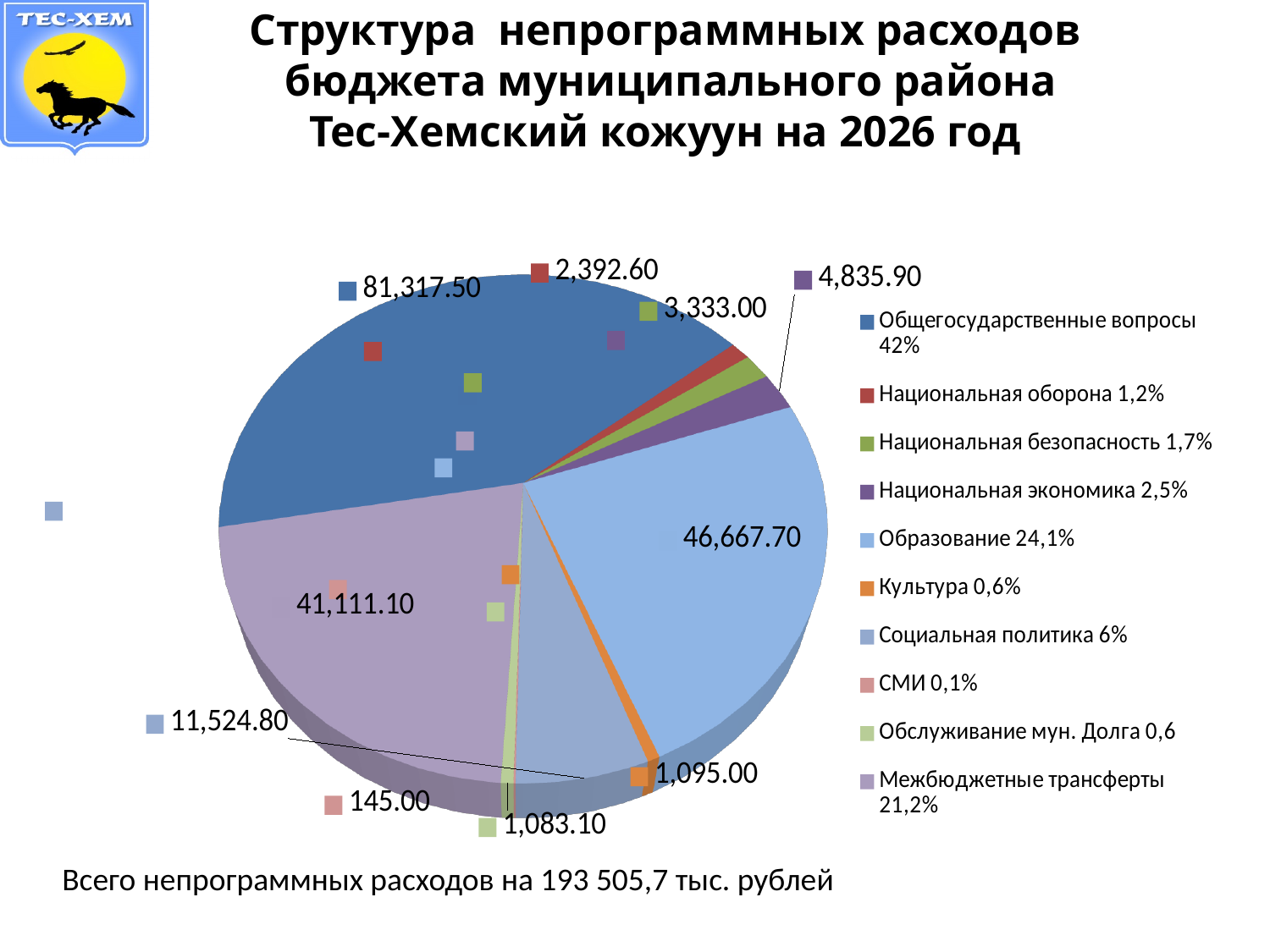
What is the value shown for Общегосударственные вопросы? 81,317.50 What is the value shown for Образование? 46,667.70 Which category has the largest slice of the pie? Общегосударственные вопросы What share of the pie does Образование represent, according to the legend? 24,1% What is the value shown for Социальная политика? 11,524.80 What type of chart is shown on the slide? pie chart What is the difference between the values for Общегосударственные вопросы and Образование? 34,649.80 Which category has the smallest slice of the pie? СМИ Which is larger, the value for Образование or the value for Межбюджетные трансферты? Образование What is the value shown for Межбюджетные трансферты? 41,111.10 What total amount of non-programme expenditures is stated below the chart? 193 505,7 тыс. рублей How many categories does the pie chart contain? 10